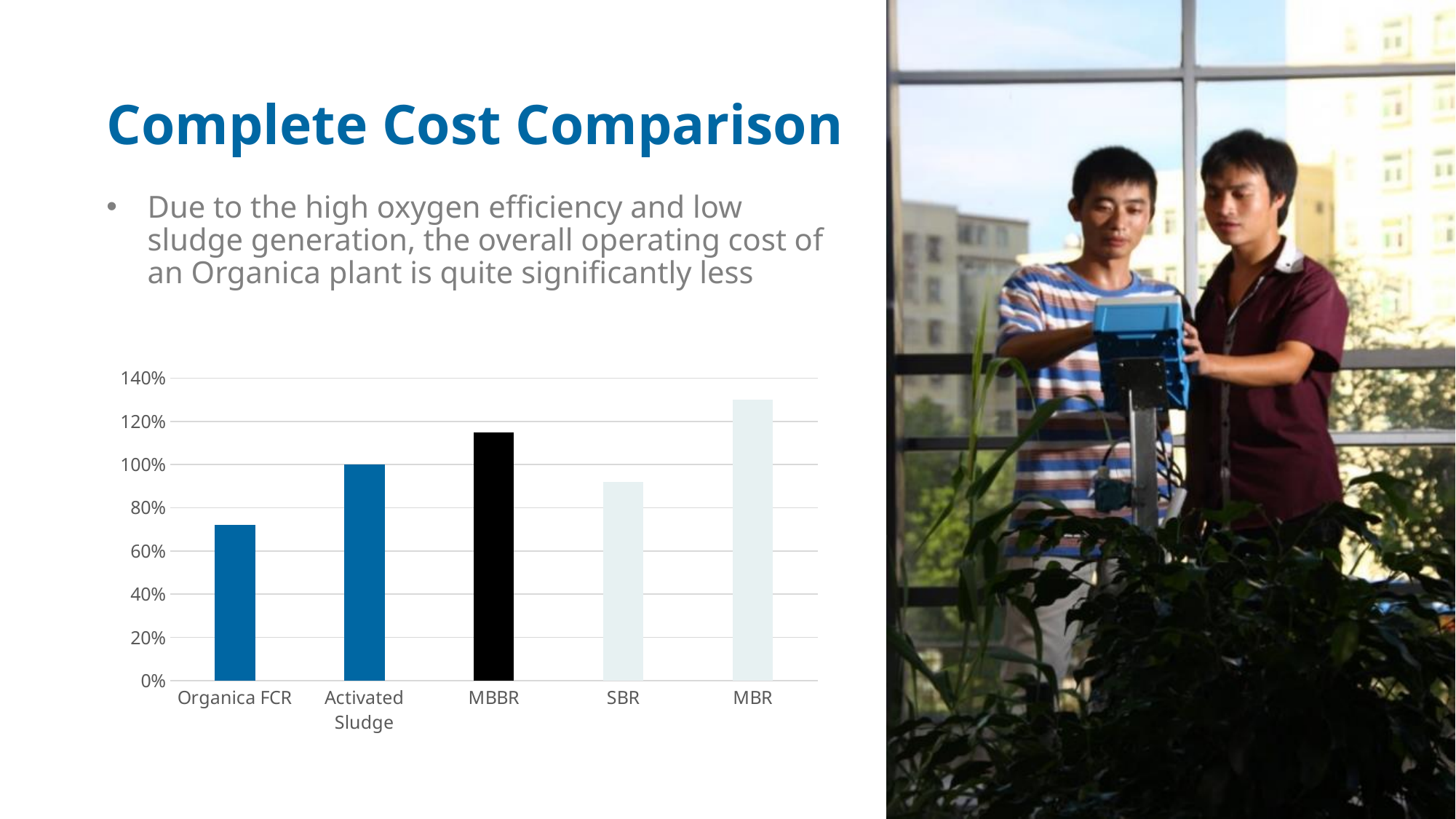
Is the value for MBBR greater or less than 100%? greater Is the value for SBR greater or less than 100%? less Is the value for MBR greater or less than 120%? greater Which category has the highest value? MBR Which is larger, the value for MBBR or the value for SBR? MBBR Which is larger, the value for Organica FCR or the value for Activated Sludge? Activated Sludge What is the value for Activated Sludge? 100% How many categories are shown on the x axis of the chart? 5 Which category has the lowest value? Organica FCR What type of chart is shown on the slide? bar chart What is the title of the slide containing the chart? Complete Cost Comparison